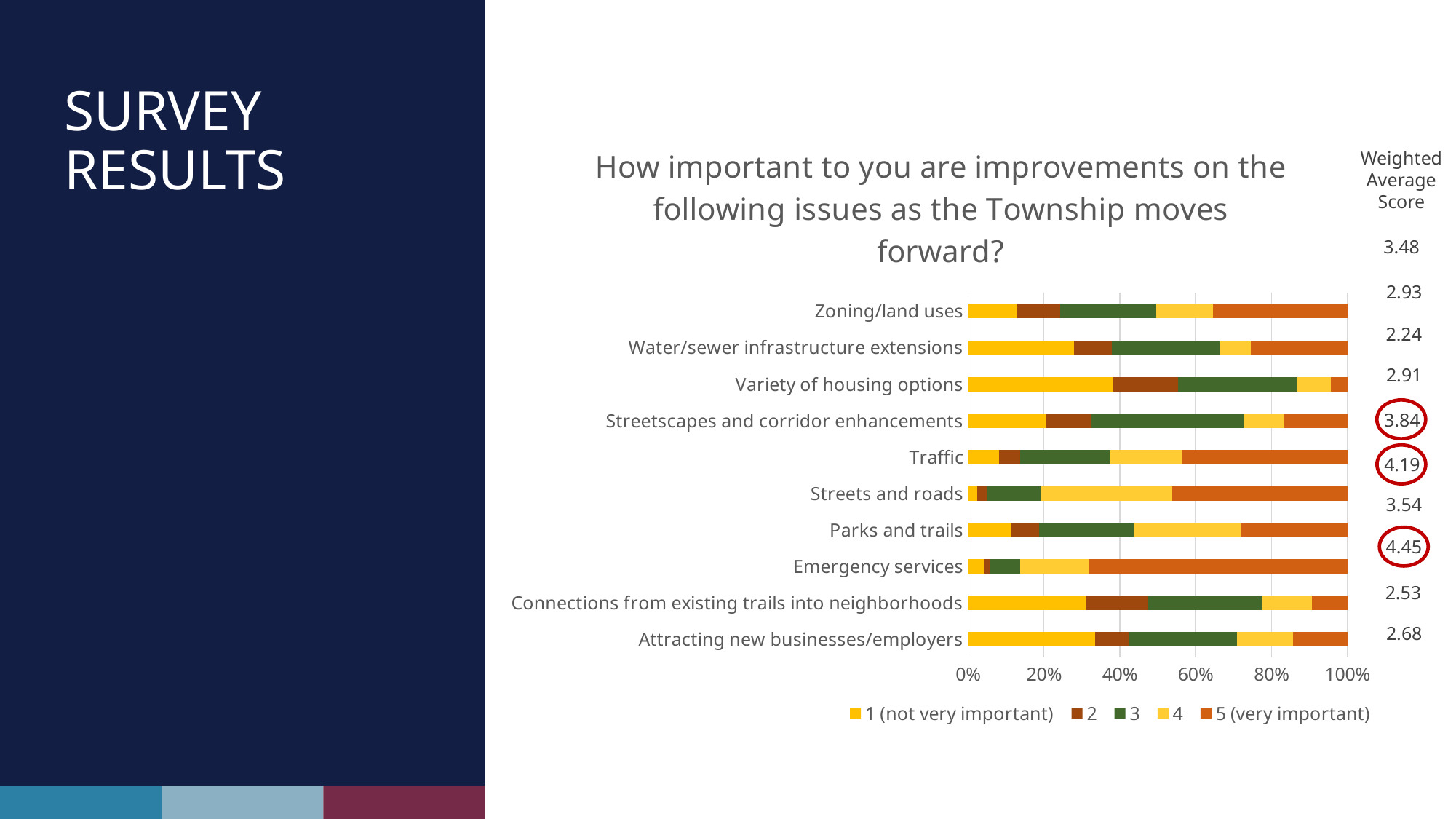
Is the '5 (very important)' share for Emergency services greater or less than 60%? greater What is the label of the last legend entry? 5 (very important) Is the '1 (not very important)' share for Streets and roads greater or less than 20%? less Is the '1 (not very important)' share for Variety of housing options greater or less than 20%? greater How many issue categories are plotted on the chart? 10 What is the label of the first legend entry? 1 (not very important) What is the highest circled Weighted Average Score shown next to the chart? 4.45 Which has a larger '5 (very important)' share: Traffic or Variety of housing options? Traffic How many series does the chart legend list? 5 Which category has the largest '5 (very important)' segment? Emergency services Which has a larger '1 (not very important)' share: Emergency services or Attracting new businesses/employers? Attracting new businesses/employers What kind of chart is shown on the slide? Stacked bar chart